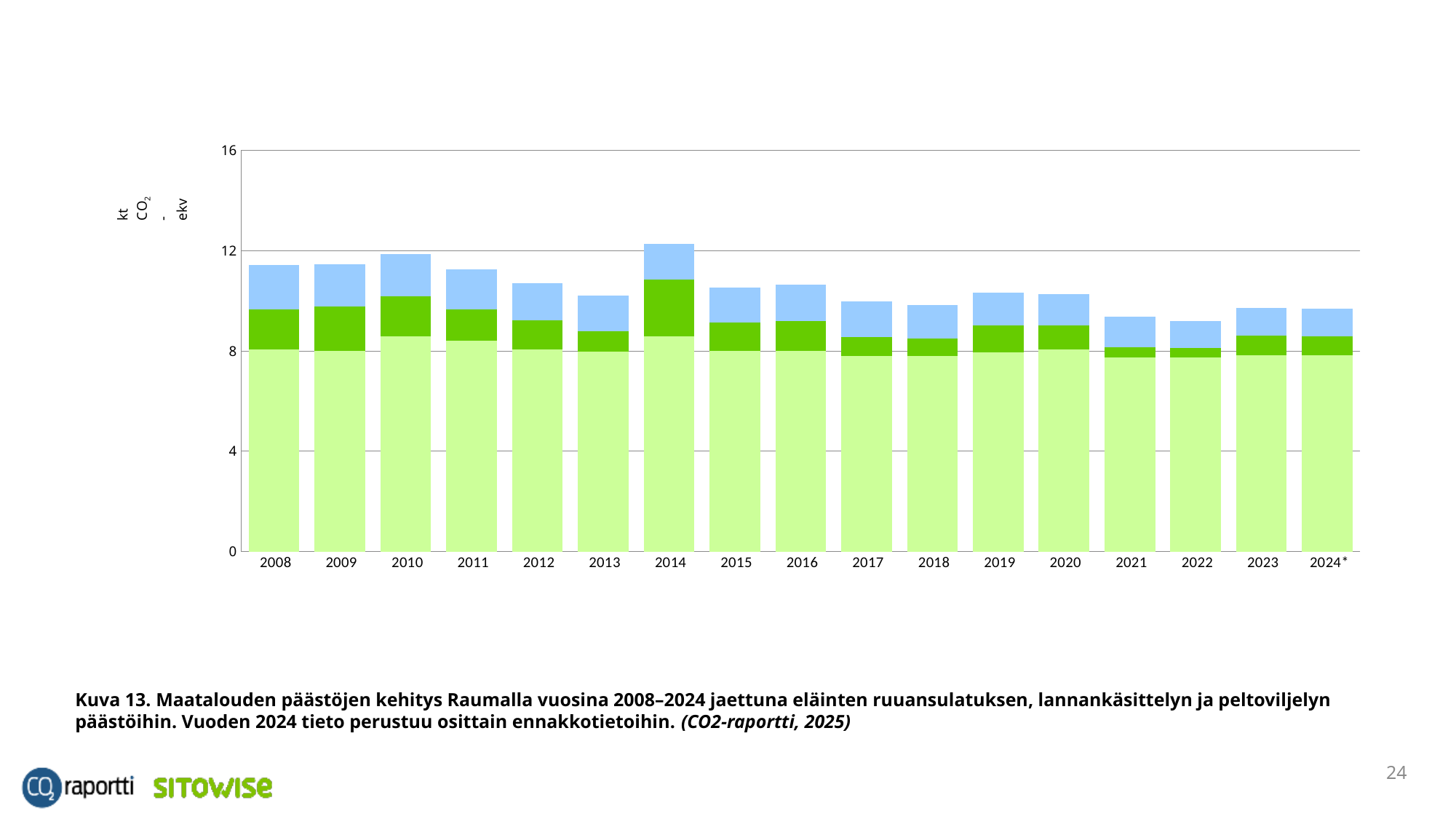
Is the total for 2013 greater or less than 8? greater Is the total for 2014 greater or less than 12? greater What unit is shown on the y axis? kt CO2-ekv Which year has the larger total bar, 2008 or 2022? 2008 Do the total bar heights generally rise or fall from 2008 to 2024*? fall How many differently coloured segments make up each stacked bar? 3 Which year has the larger total bar, 2013 or 2014? 2014 What kind of chart is shown on the slide? stacked bar chart Which year has the highest total bar? 2014 Is the total for 2022 greater or less than 10? less How many years (categories) are shown on the x axis? 17